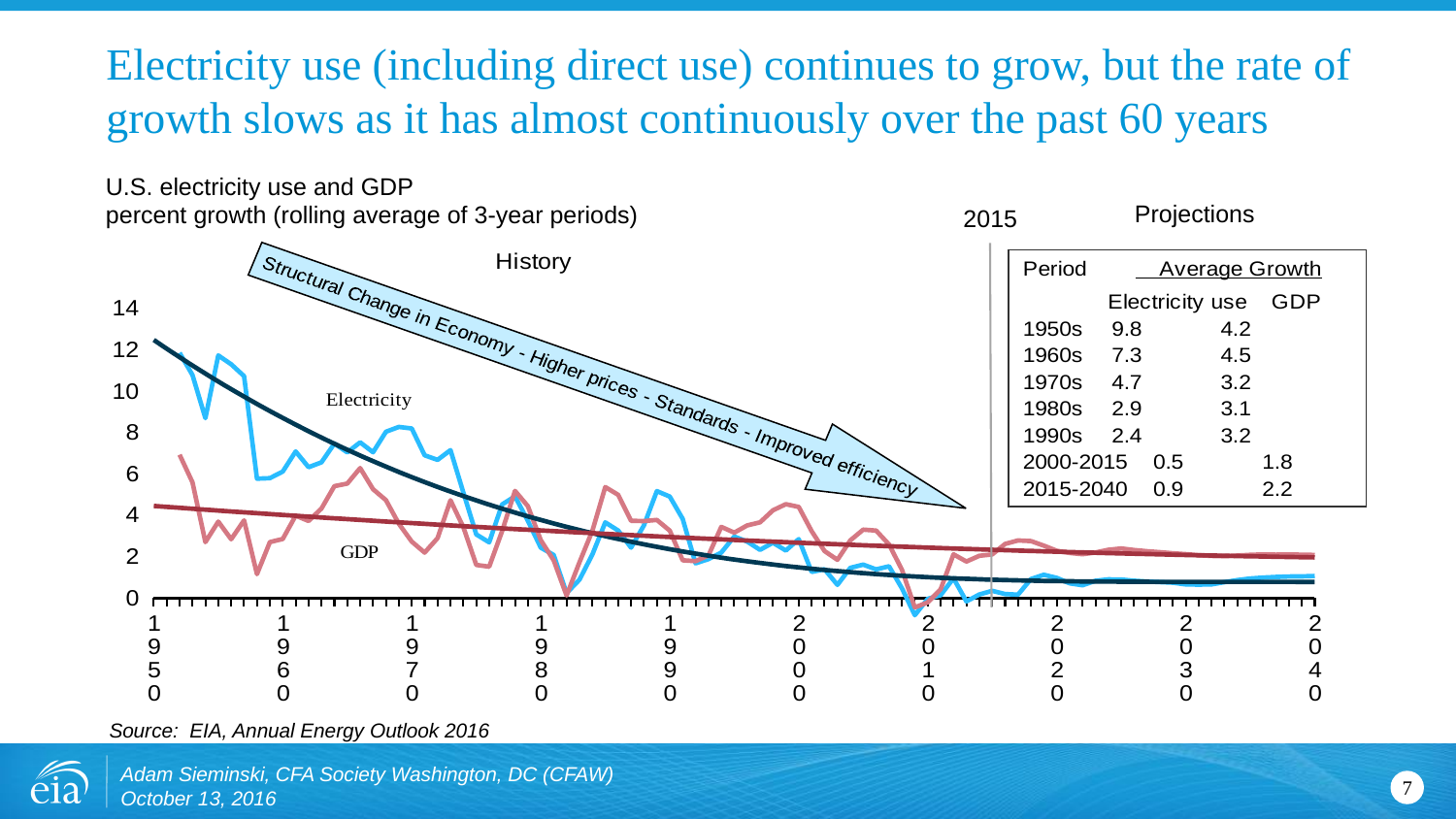
Which period in the table has the highest average growth of electricity use? 1950s Is the Electricity line's value at 2040 greater or less than 2? less According to the table, what was the average growth of electricity use in the 1950s? 9.8 What kind of chart is shown on the slide? line chart In the table, what is the difference between electricity use growth and GDP growth in the 1950s? 5.6 How many data series are labeled on the chart? 2 Which period in the table has the lowest average growth of electricity use? 2000-2015 In the table, which is larger for the 1970s: average growth of electricity use or GDP? Electricity use What source is cited below the chart? EIA, Annual Energy Outlook 2016 According to the table, what was the average GDP growth in the 1960s? 4.5 According to the table, what is the projected average growth of electricity use for 2015-2040? 0.9 Does the smoothed trend line for Electricity rise or fall from 1950 to 2040? fall